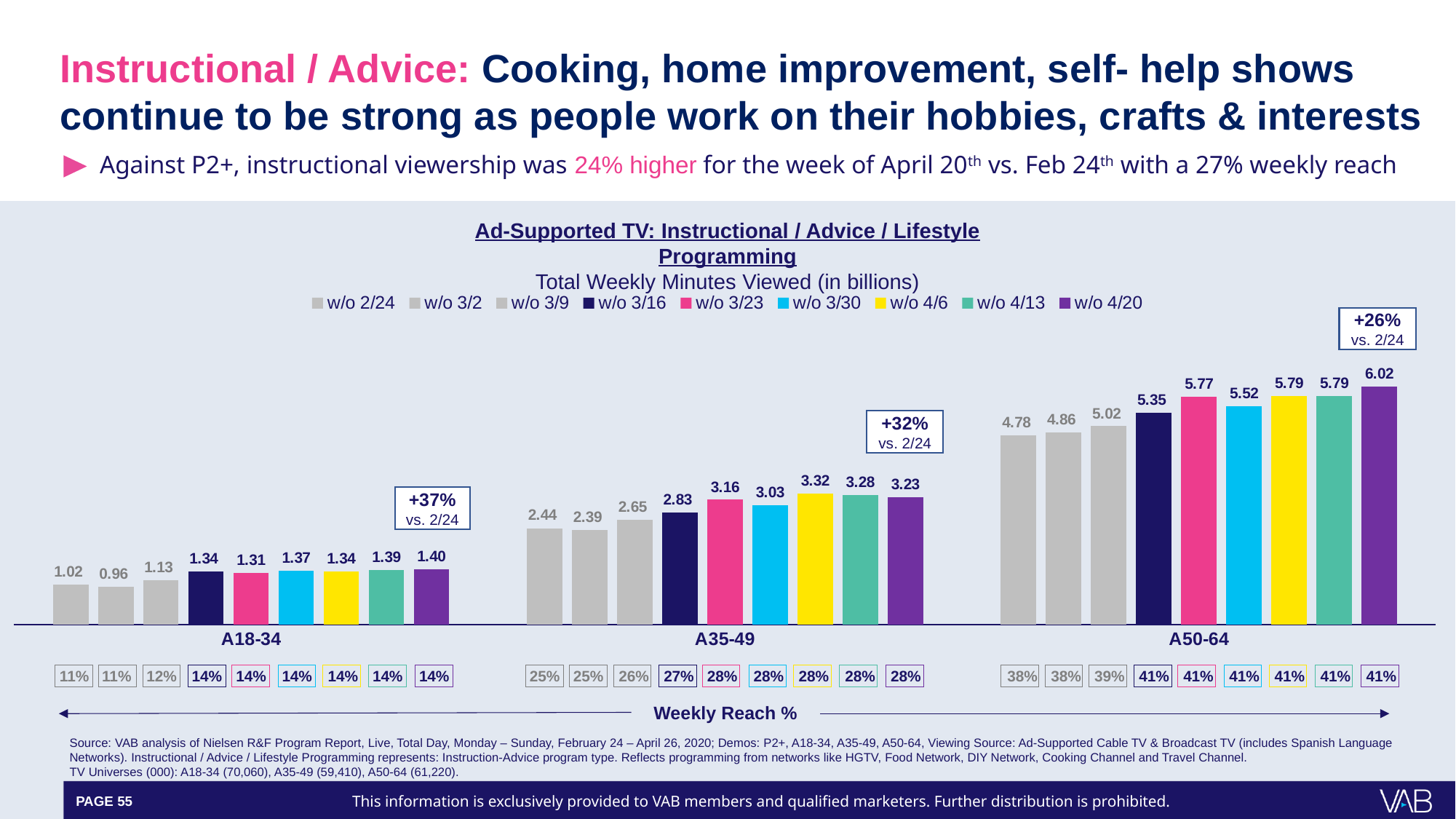
What percentage change vs. 2/24 is annotated above the A18-34 group? +37% What is the value for A18-34 in the week of 2/24? 1.02 What is the total weekly minutes viewed (in billions) for A50-64 in the week of 4/20? 6.02 For A35-49, which is larger: the value for w/o 3/23 or w/o 3/30? w/o 3/23 How many series (weeks) does the legend list? 9 What is the value for A35-49 in the week of 4/6? 3.32 Within the A35-49 group, which week has the highest total weekly minutes viewed? w/o 4/6 How many age groups are shown on the x axis? 3 Within the A18-34 group, which week has the lowest total weekly minutes viewed? w/o 3/2 For A18-34, what is the difference between the w/o 4/20 value and the w/o 2/24 value? 0.38 For A50-64, how much higher is the value for w/o 4/20 than for w/o 2/24? 1.24 What kind of chart is shown on the slide? Bar chart